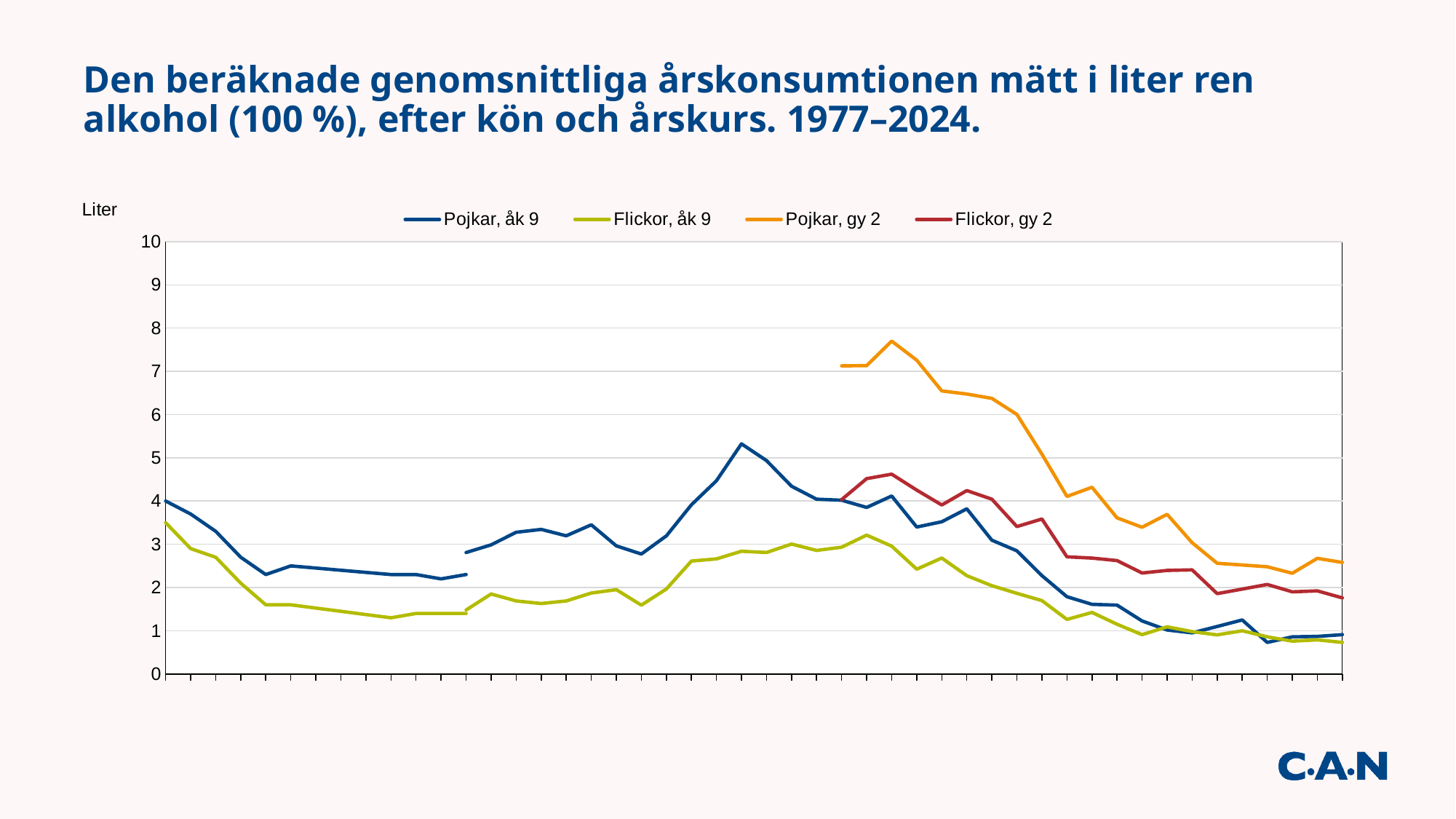
Over the most recent part of the chart, do the values of the Pojkar, gy 2 series generally rise or fall? fall Is the peak value of the Flickor, gy 2 series greater or less than 5? less Which series has the highest value at the right end of the chart? Pojkar, gy 2 Which series reaches the highest value anywhere on the chart? Pojkar, gy 2 What unit is shown on the y axis? Liter How many series does the legend list? 4 At the right end of the chart, is the value for Pojkar, gy 2 larger or smaller than the value for Flickor, gy 2? larger Is the peak value of the Pojkar, gy 2 series greater or less than 7? greater Is the peak value of the Flickor, åk 9 series greater or less than 4? less What is the highest value shown on the y axis? 10 What kind of chart is shown on the slide? line chart